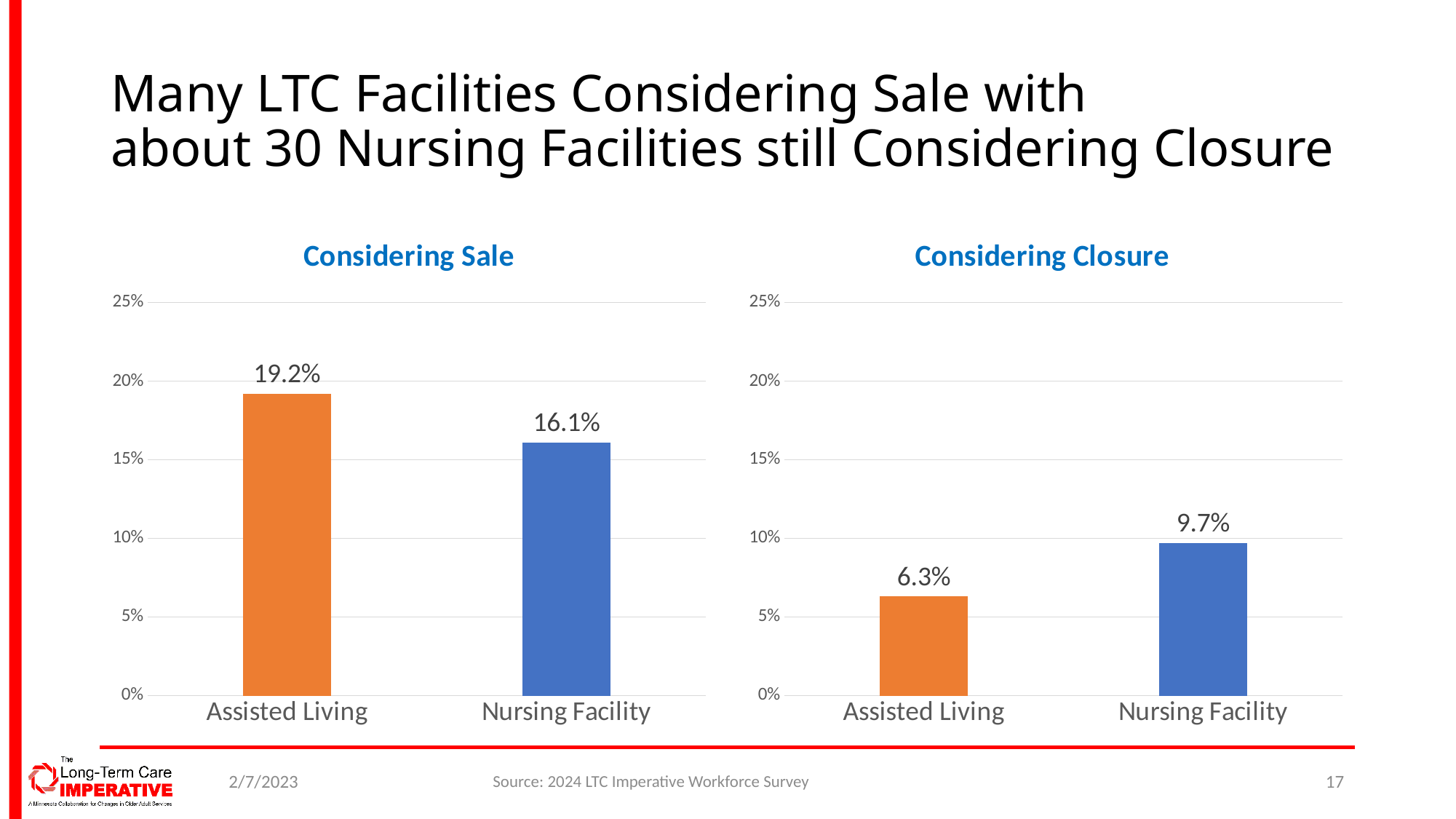
What kind of chart is the 'Considering Closure' chart? Bar chart How many categories are shown in the 'Considering Sale' chart? 2 In the 'Considering Closure' chart, which is larger: Assisted Living or Nursing Facility? Nursing Facility In the 'Considering Closure' chart, is the value for Nursing Facility greater or less than 10%? less In the 'Considering Sale' chart, which category has the highest value? Assisted Living In the 'Considering Sale' chart, what is the value for Assisted Living? 19.2% In the 'Considering Sale' chart, what is the difference between the Assisted Living and Nursing Facility values? 3.1% In the 'Considering Closure' chart, what is the value for Assisted Living? 6.3% In the 'Considering Sale' chart, what is the value for Nursing Facility? 16.1% In the 'Considering Closure' chart, which category has the lowest value? Assisted Living In the 'Considering Closure' chart, what is the value for Nursing Facility? 9.7% In the 'Considering Closure' chart, what is the difference between the Nursing Facility and Assisted Living values? 3.4%